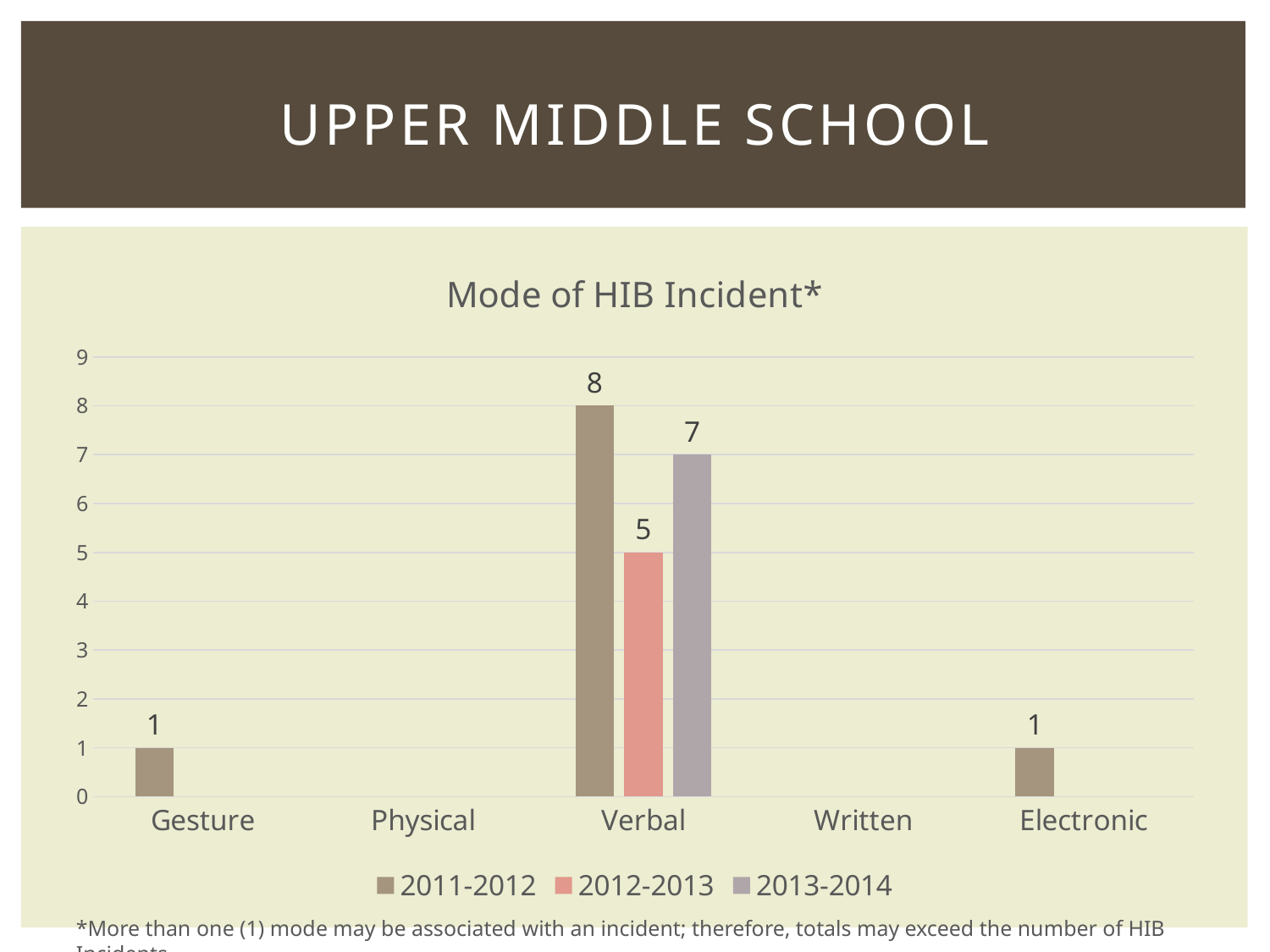
How many categories are shown on the x axis? 5 What is the value for Gesture in the 2011-2012 series? 1 Which is larger for Verbal: the 2012-2013 value or the 2013-2014 value? 2013-2014 What kind of chart is shown on the slide? Bar chart What is the title of the chart? Mode of HIB Incident* What is the value for Electronic in the 2011-2012 series? 1 What is the value for Verbal in the 2011-2012 series? 8 Which category has the highest value in the 2011-2012 series? Verbal What is the difference between the 2011-2012 and 2012-2013 values for Verbal? 3 What is the value for Verbal in the 2012-2013 series? 5 What is the value for Verbal in the 2013-2014 series? 7 How many series does the legend list? 3